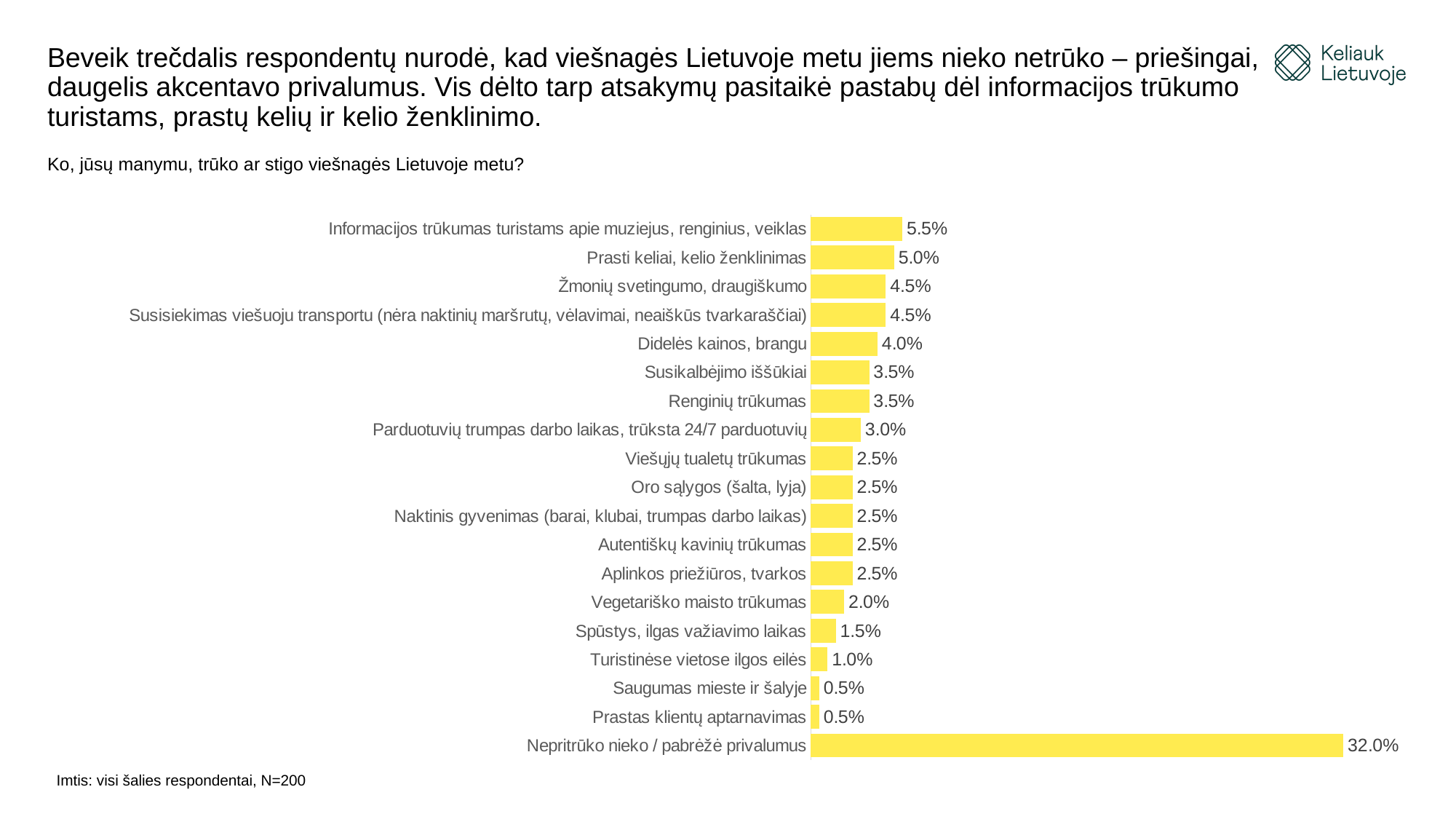
What is the value for "Turistinėse vietose ilgos eilės"? 1.0% What is the value for "Didelės kainos, brangu"? 4.0% What is the difference between "Nepritrūko nieko / pabrėžė privalumus" and "Informacijos trūkumas turistams apie muziejus, renginius, veiklas"? 26.5% What is the value for "Prasti keliai, kelio ženklinimas"? 5.0% Which category has the highest value? Nepritrūko nieko / pabrėžė privalumus What is the difference between "Informacijos trūkumas turistams apie muziejus, renginius, veiklas" and "Prasti keliai, kelio ženklinimas"? 0.5% What is the value for "Vegetariško maisto trūkumas"? 2.0% Which is larger: "Susikalbėjimo iššūkiai" or "Spūstys, ilgas važiavimo laikas"? Susikalbėjimo iššūkiai What colour are the bars in the chart? Yellow How many categories are shown in the chart? 19 What is the value for "Nepritrūko nieko / pabrėžė privalumus"? 32.0% What kind of chart is shown on the slide? Bar chart